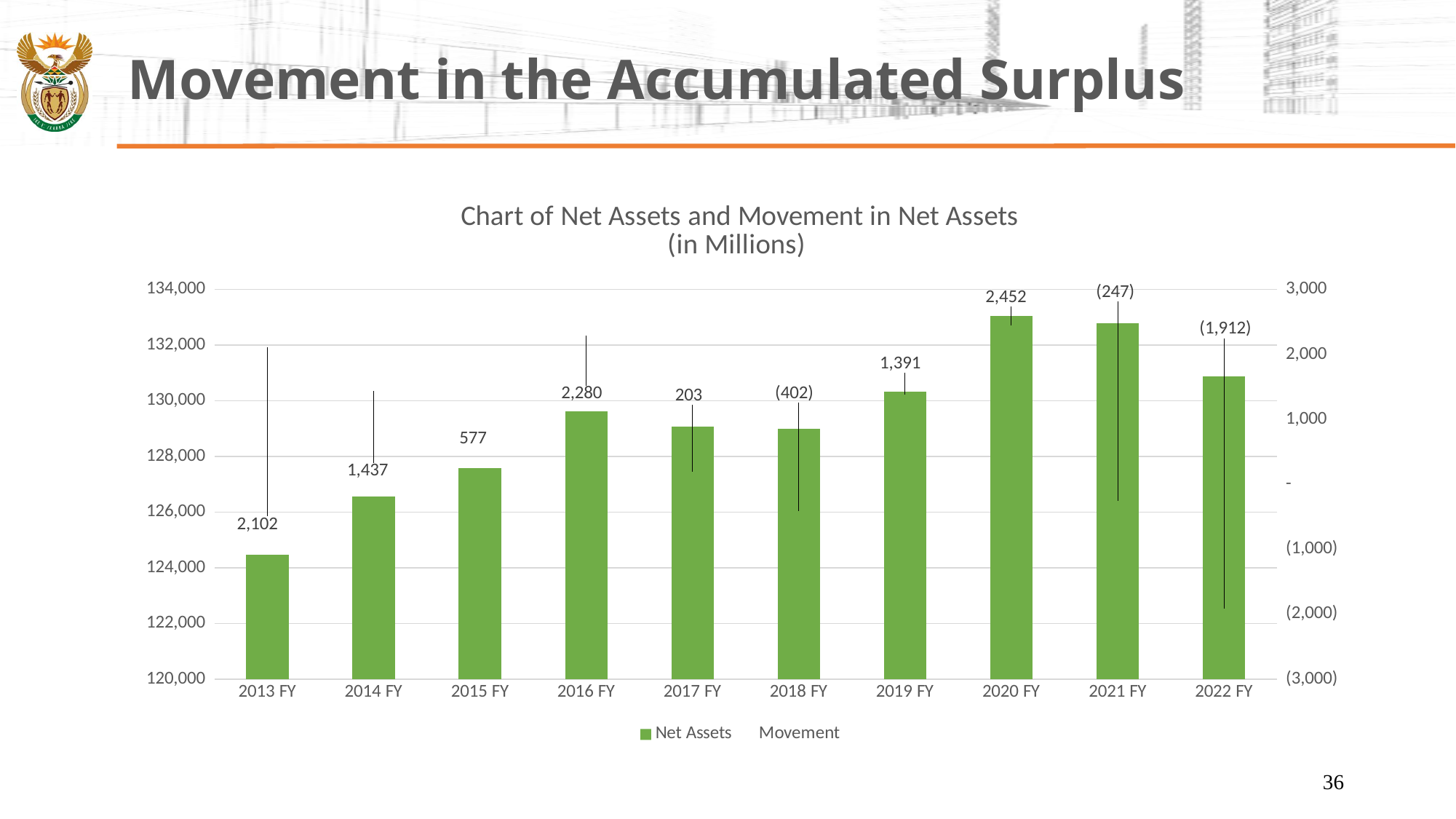
How many fiscal years are shown on the x axis? 10 Which fiscal year has the tallest Net Assets bar? 2020 FY What is the Movement value labelled for 2018 FY? (402) Is the Net Assets bar for 2015 FY greater or less than 128,000? less What is the Movement value labelled for 2016 FY? 2,280 Which fiscal year has the lowest labelled Movement value? 2022 FY Which is larger, the Movement value for 2014 FY or for 2019 FY? 2014 FY How many series does the legend list? 2 Is the Net Assets bar for 2020 FY greater or less than 132,000? greater What is the difference between the Movement values for 2020 FY and 2016 FY? 172 What is the Movement value labelled for 2022 FY? (1,912) Which fiscal year has the highest labelled Movement value? 2020 FY